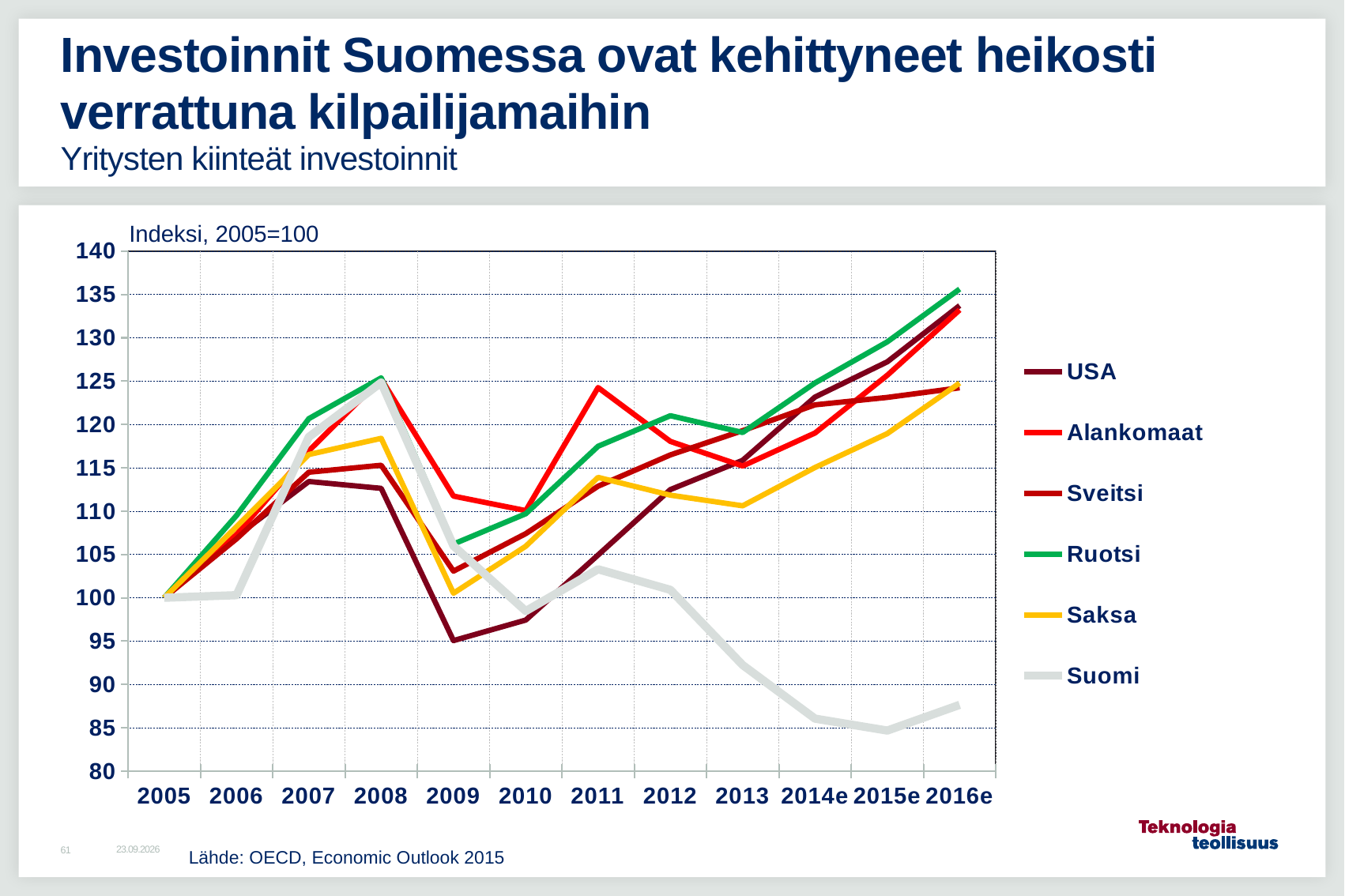
How many series does the legend list? 6 How many years (points) are shown along the x axis? 12 Does the Suomi line rise or fall from 2011 to 2015e? fall Which series has the lowest value in 2009? USA Is the value for Suomi in 2016e greater or less than 90? less Which series has the highest value in 2016e? Ruotsi Which is larger in 2011, the value for Alankomaat or the value for USA? Alankomaat What kind of chart is shown on the slide? line chart Is the value for Ruotsi in 2016e greater or less than 130? greater What is the index value for Suomi in 2005? 100 Which series has the lowest value in 2016e? Suomi Is the value for Alankomaat in 2011 greater or less than 120? greater